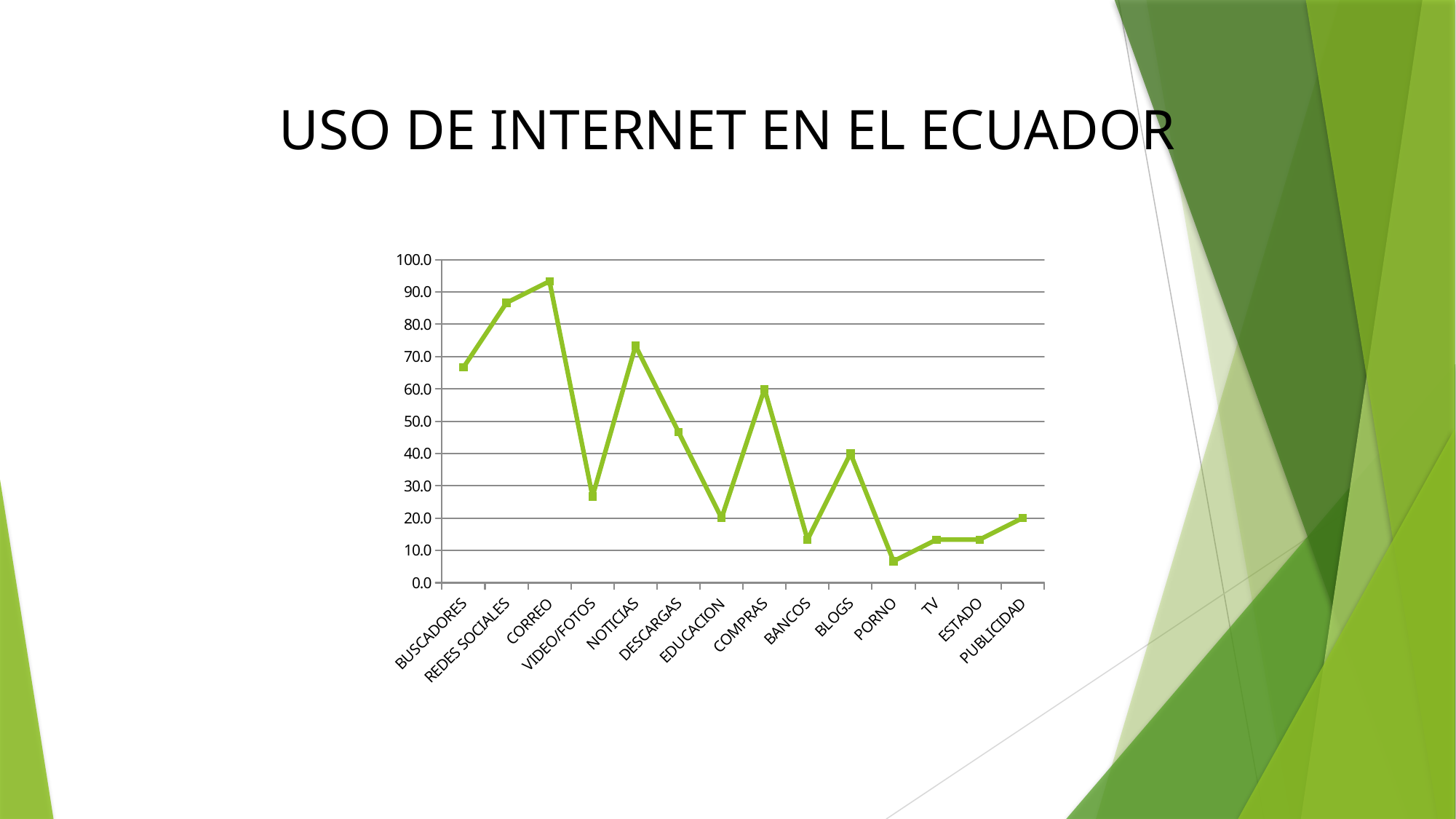
Which category has the lowest value in the chart? PORNO Is the value for NOTICIAS greater or less than 70.0? greater Which has a higher value, COMPRAS or DESCARGAS? COMPRAS Is the value for VIDEO/FOTOS greater or less than 30.0? less Is the value for BANCOS greater or less than 20.0? less What is the title of the slide containing the chart? USO DE INTERNET EN EL ECUADOR What kind of chart is shown on the slide? line chart Which category has the highest value in the chart? CORREO Does the line rise or fall from CORREO to VIDEO/FOTOS? fall How many categories are plotted along the x axis of the chart? 14 Which has a higher value, REDES SOCIALES or BUSCADORES? REDES SOCIALES